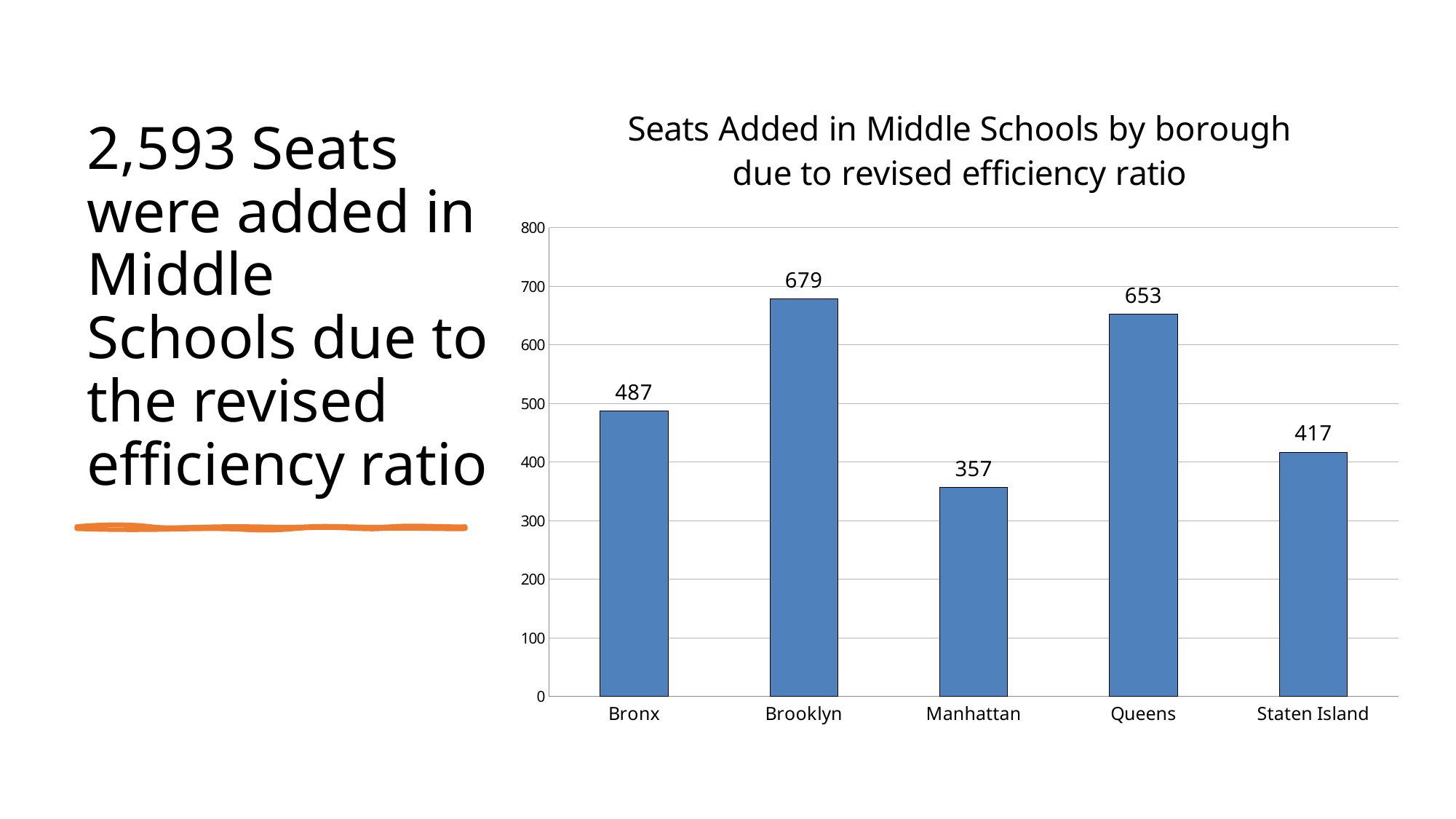
Which borough has the highest number of seats added? Brooklyn What is the difference between the values for Bronx and Manhattan? 130 What kind of chart is shown on the slide? bar chart Is the value for Queens greater or less than 600? greater What is the difference between the values for Brooklyn and Queens? 26 Which borough has the lowest number of seats added? Manhattan What is the value for Bronx? 487 What is the value for Staten Island? 417 What is the value for Manhattan? 357 How many boroughs are shown on the x axis? 5 What is the title of the chart? Seats Added in Middle Schools by borough due to revised efficiency ratio Which is larger, the value for Bronx or the value for Staten Island? Bronx